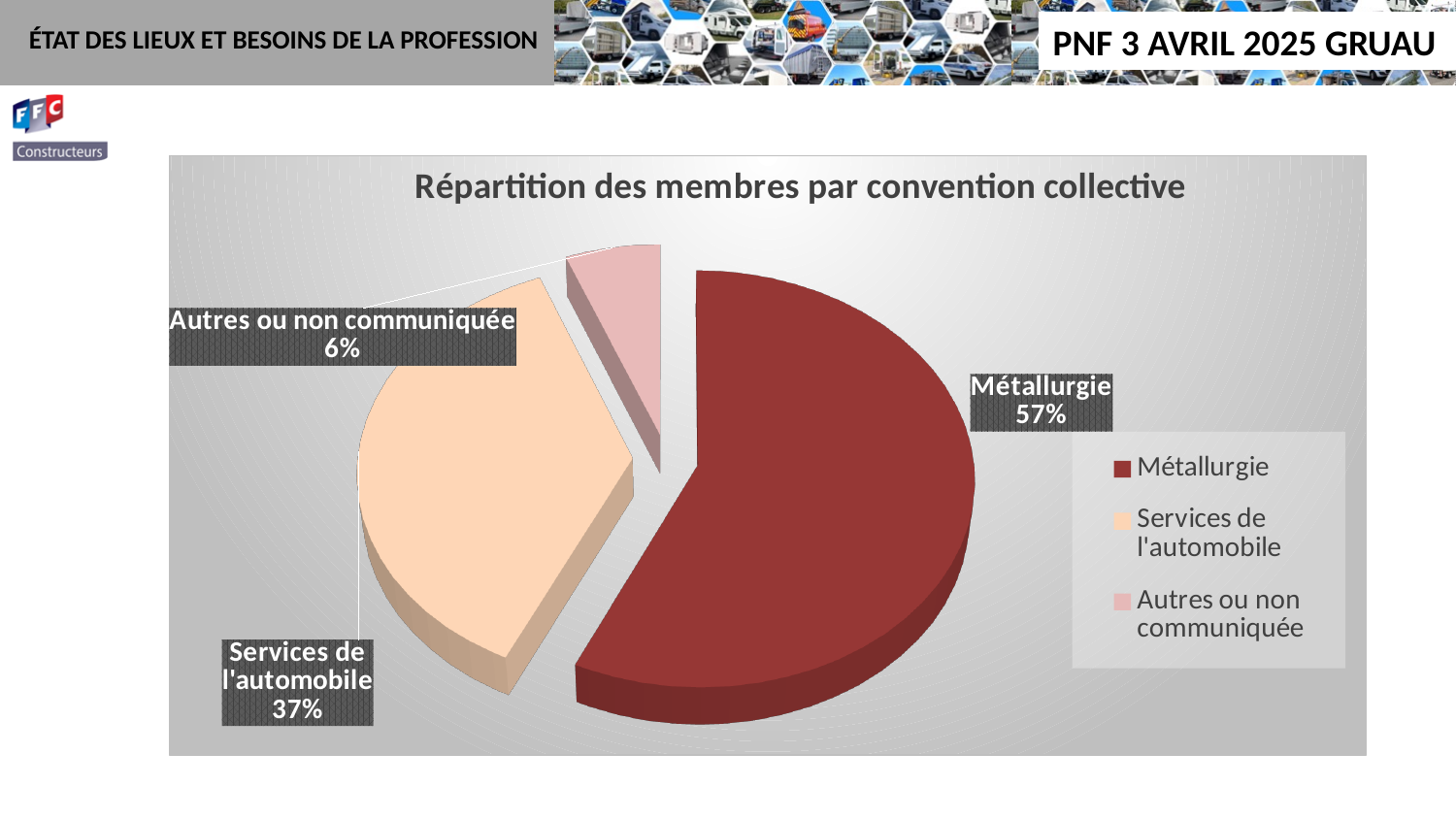
Which is larger: the share for Services de l'automobile or the share for Autres ou non communiquée? Services de l'automobile What share of members falls under Autres ou non communiquée? 6% What share of members is under the Métallurgie convention collective? 57% How many slices does the pie chart have? 3 What is the difference in percentage points between Métallurgie and Services de l'automobile? 20 percentage points Which convention collective has the largest share of members? Métallurgie What kind of chart is shown on the slide? Pie chart Which category has the smallest share of members? Autres ou non communiquée How many entries does the legend list? 3 What is the title of the chart? Répartition des membres par convention collective What share of members is under Services de l'automobile? 37% Is the share for Métallurgie greater or less than 50%? greater